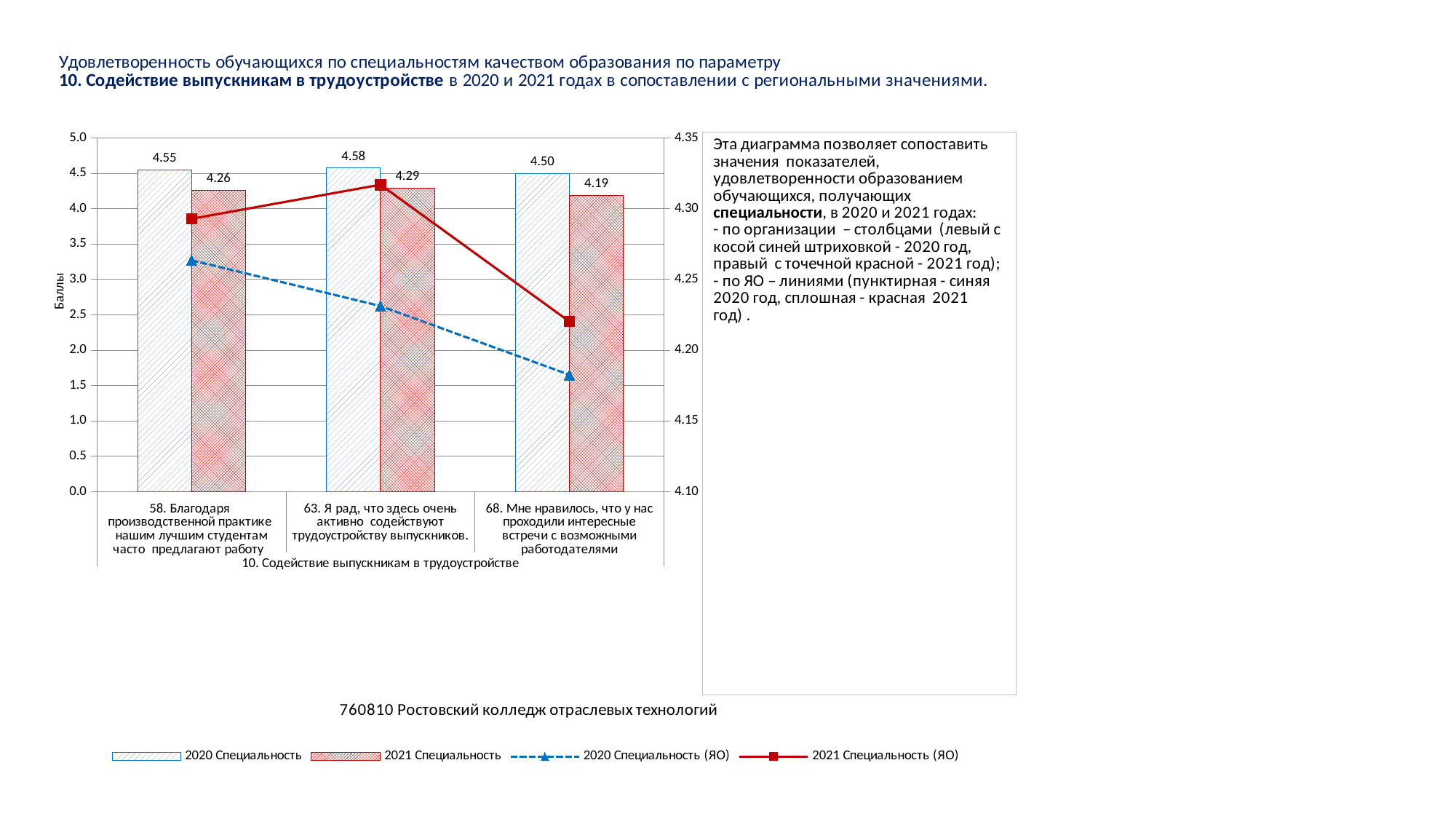
How many series does the legend list? 4 What is the value of the 2021 Специальность bar for item 68 (Мне нравилось, что у нас проходили интересные встречи с возможными работодателями)? 4.19 Which item has the highest 2020 Специальность bar? 63. Я рад, что здесь очень активно содействуют трудоустройству выпускников. Which is larger for item 58: the 2020 Специальность bar or the 2021 Специальность bar? 2020 Специальность (4.55) What is the difference between the 2020 and 2021 Специальность bars for item 68? 0.31 Which item has the lowest 2021 Специальность bar? 68. Мне нравилось, что у нас проходили интересные встречи с возможными работодателями How many items (categories) are shown on the x axis? 3 What is the value of the 2021 Специальность bar for item 63 (Я рад, что здесь очень активно содействуют трудоустройству выпускников)? 4.29 On the right-hand axis, is the 2021 Специальность (ЯО) line value for item 68 greater or less than 4.20? greater On the right-hand axis, is the 2020 Специальность (ЯО) line value for item 68 greater or less than 4.20? less Does the dashed blue 2020 Специальность (ЯО) line rise or fall from item 58 to item 68? fall What is the value of the 2020 Специальность bar for item 58 (Благодаря производственной практике нашим лучшим студентам часто предлагают работу)? 4.55